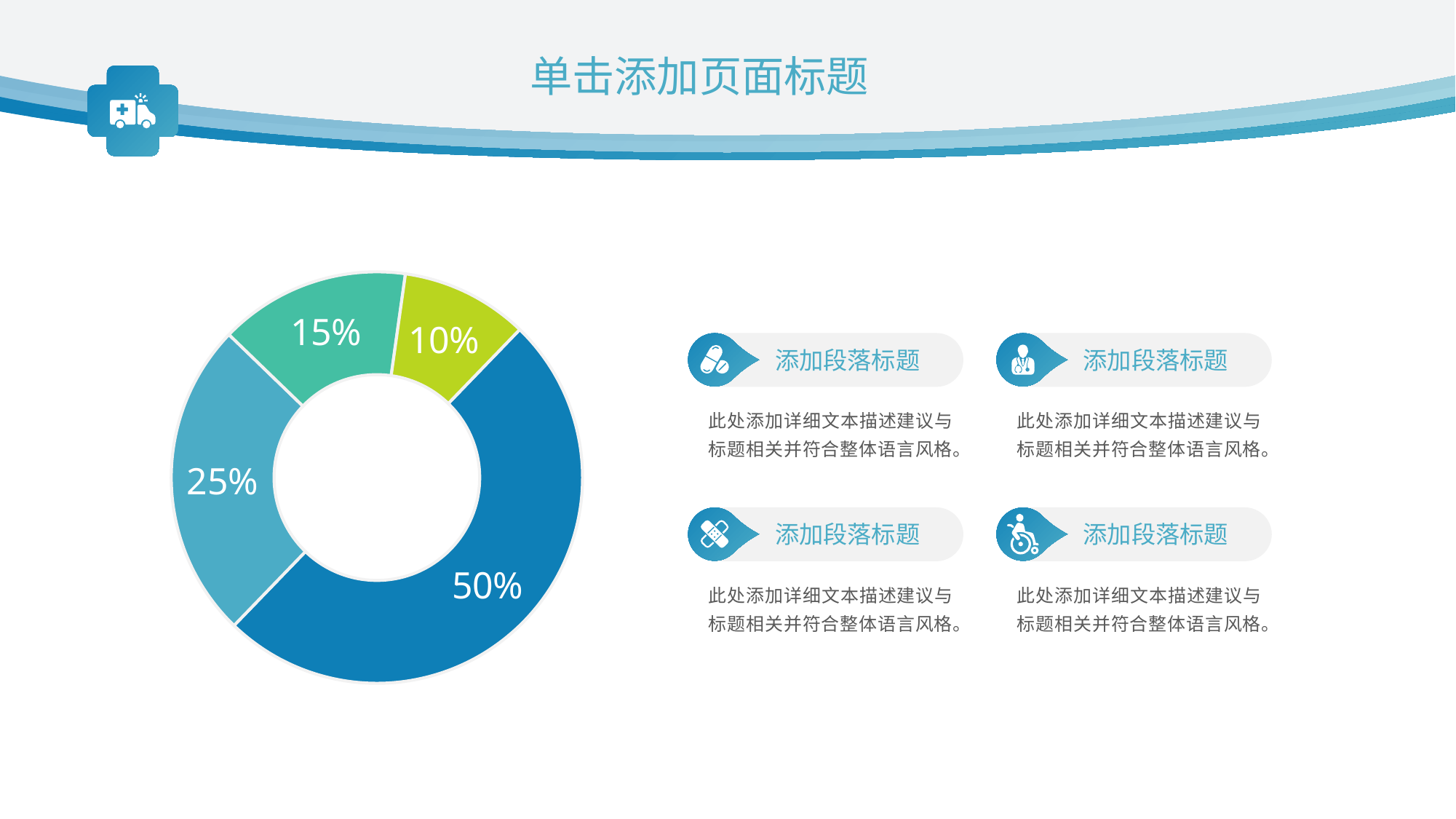
What is the total of all the slice values shown in the doughnut chart? 100% What percentage is shown on the teal green slice of the doughnut chart? 15% What is the value shown on the largest slice of the doughnut chart? 50% What percentage is shown on the dark blue slice of the doughnut chart? 50% What is the difference between the dark blue slice and the light blue slice in the doughnut chart? 25% What percentage is shown on the light blue slice of the doughnut chart? 25% What kind of chart is shown on the slide? doughnut chart What percentage is shown on the lime green slice of the doughnut chart? 10% Does the doughnut chart display a legend? No How many slices does the doughnut chart have? 4 What is the value shown on the smallest slice of the doughnut chart? 10% Which slice is larger in the doughnut chart, the teal green slice or the lime green slice? the teal green slice